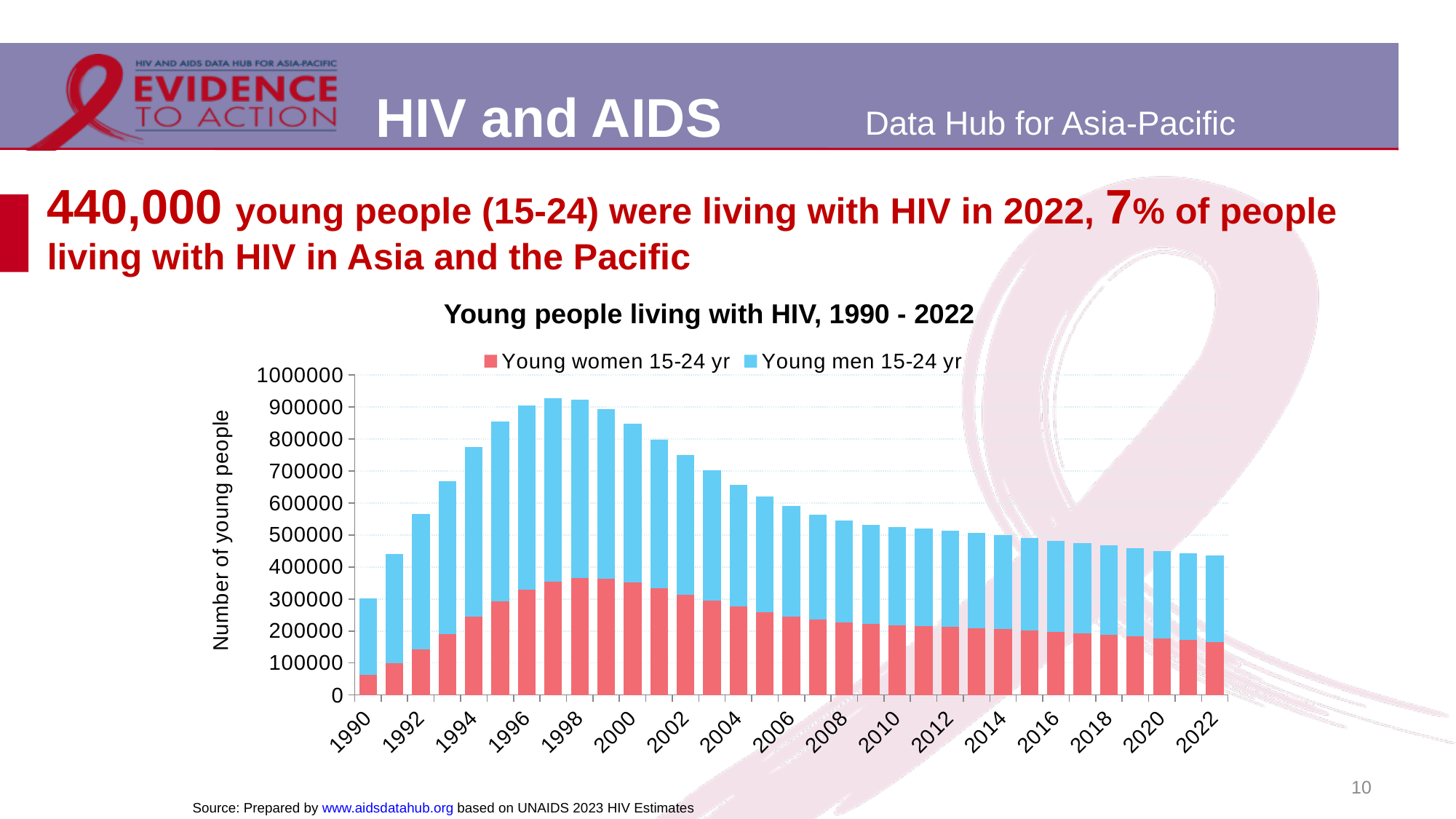
Is the total number of young people living with HIV in 1995 greater or less than 900000? less Which year has the lowest total number of young people living with HIV? 1990 Is the total number of young people living with HIV in 2022 greater or less than 400000? greater What are the two series named in the legend? Young women 15-24 yr and Young men 15-24 yr How many years (bars) are plotted in the chart? 33 What kind of chart is shown on the slide? Stacked bar chart Is the total number of young people living with HIV in 1990 greater or less than 400000? less Which year has the larger total number of young people living with HIV, 1990 or 2022? 2022 From 1998 to 2022, do the total values rise or fall along the x axis? fall What is the title of the chart? Young people living with HIV, 1990 - 2022 How many series does the legend list? 2